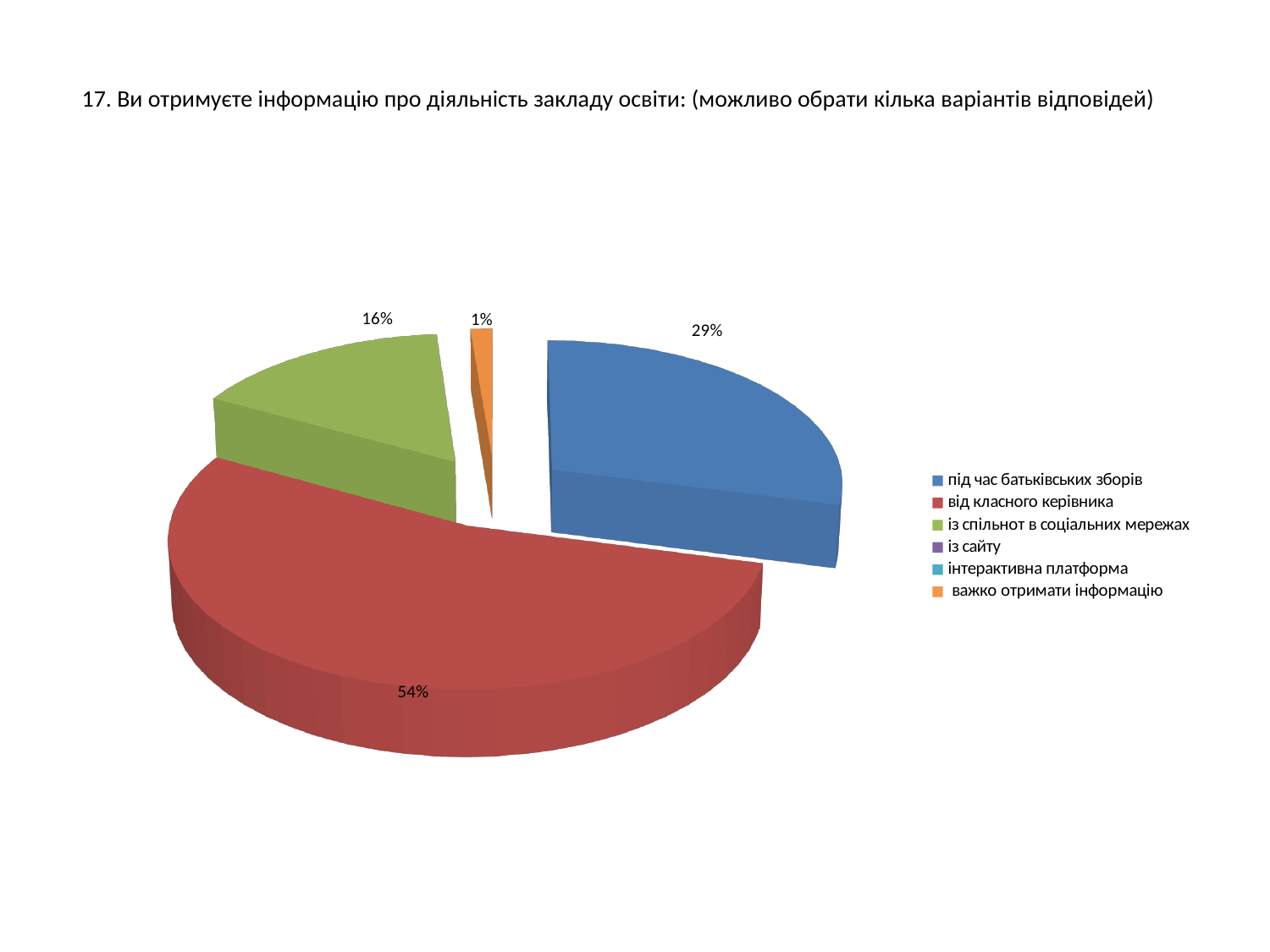
What percentage is shown for "важко отримати інформацію"? 1% Which category has the largest share of the pie? від класного керівника How many slices have a percentage label printed on the chart? 4 How many entries does the legend list? 6 Which is larger: the share for "під час батьківських зборів" or for "із спільнот в соціальних мережах"? під час батьківських зборів By how many percentage points does "від класного керівника" exceed "під час батьківських зборів"? 25 percentage points What colour is the slice for "від класного керівника"? red What percentage of the pie corresponds to "від класного керівника"? 54% Which of the labelled slices has the smallest share? важко отримати інформацію What percentage is shown for "із спільнот в соціальних мережах"? 16% What percentage is shown for "під час батьківських зборів"? 29% What type of chart is shown on the slide? pie chart